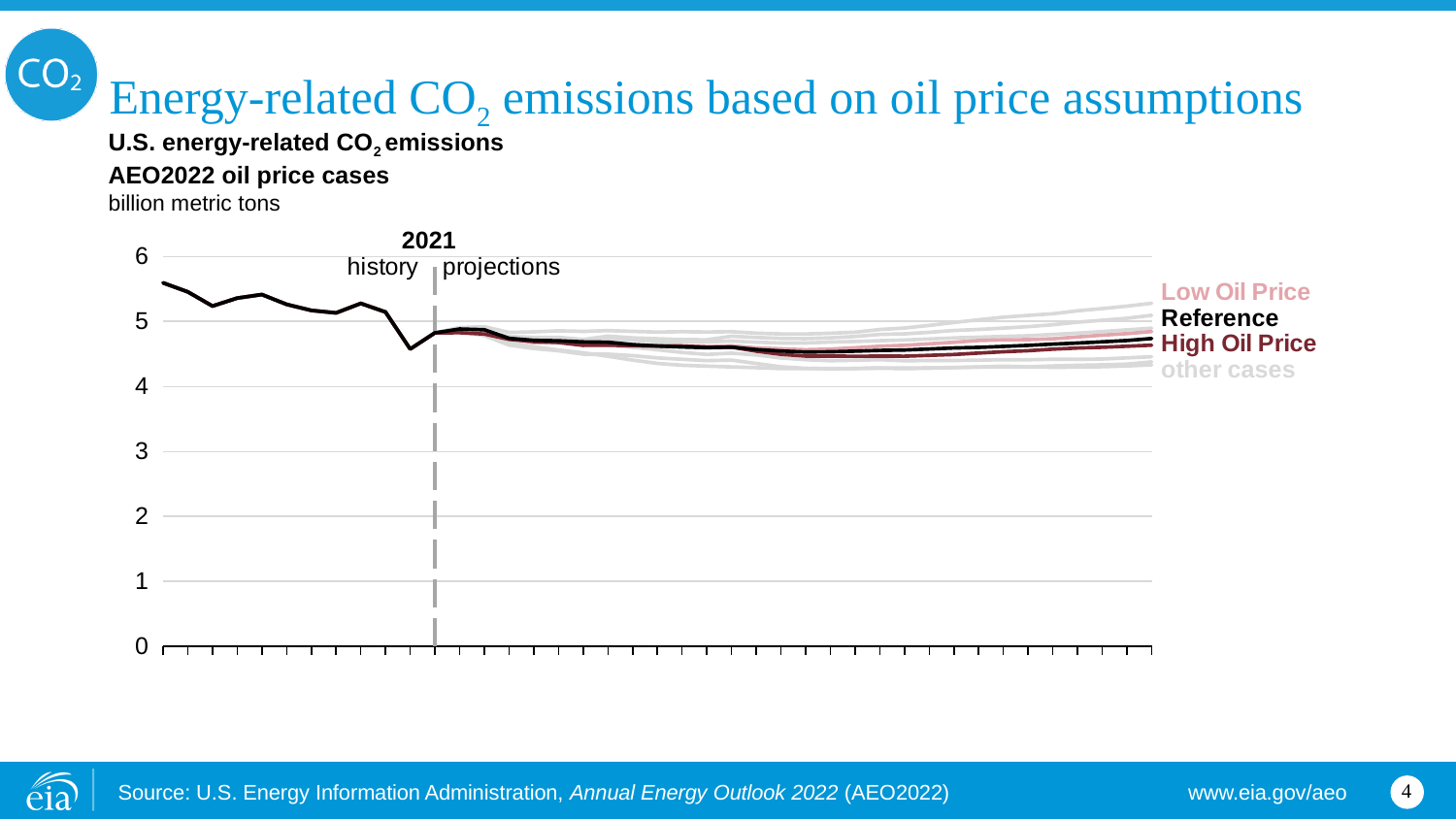
What unit is used for the y axis of the chart? billion metric tons What kind of chart is shown on the slide? line chart Among the Low Oil Price, Reference and High Oil Price cases, which has the highest emissions at the end of the projection period? Low Oil Price At the end of the projection period, which is higher: the Low Oil Price case or the High Oil Price case? Low Oil Price Is the emissions value at the start of the history line greater or less than 5? greater Over the history period, do emissions generally rise or fall? fall Is the High Oil Price case value at the end of the projection period greater or less than 4? greater Which year marks the boundary between history and projections on the chart? 2021 How many labeled series are listed at the right of the chart? 4 Among the Low Oil Price, Reference and High Oil Price cases, which has the lowest emissions at the end of the projection period? High Oil Price Is the Reference case value at the end of the projection period greater or less than 5? less